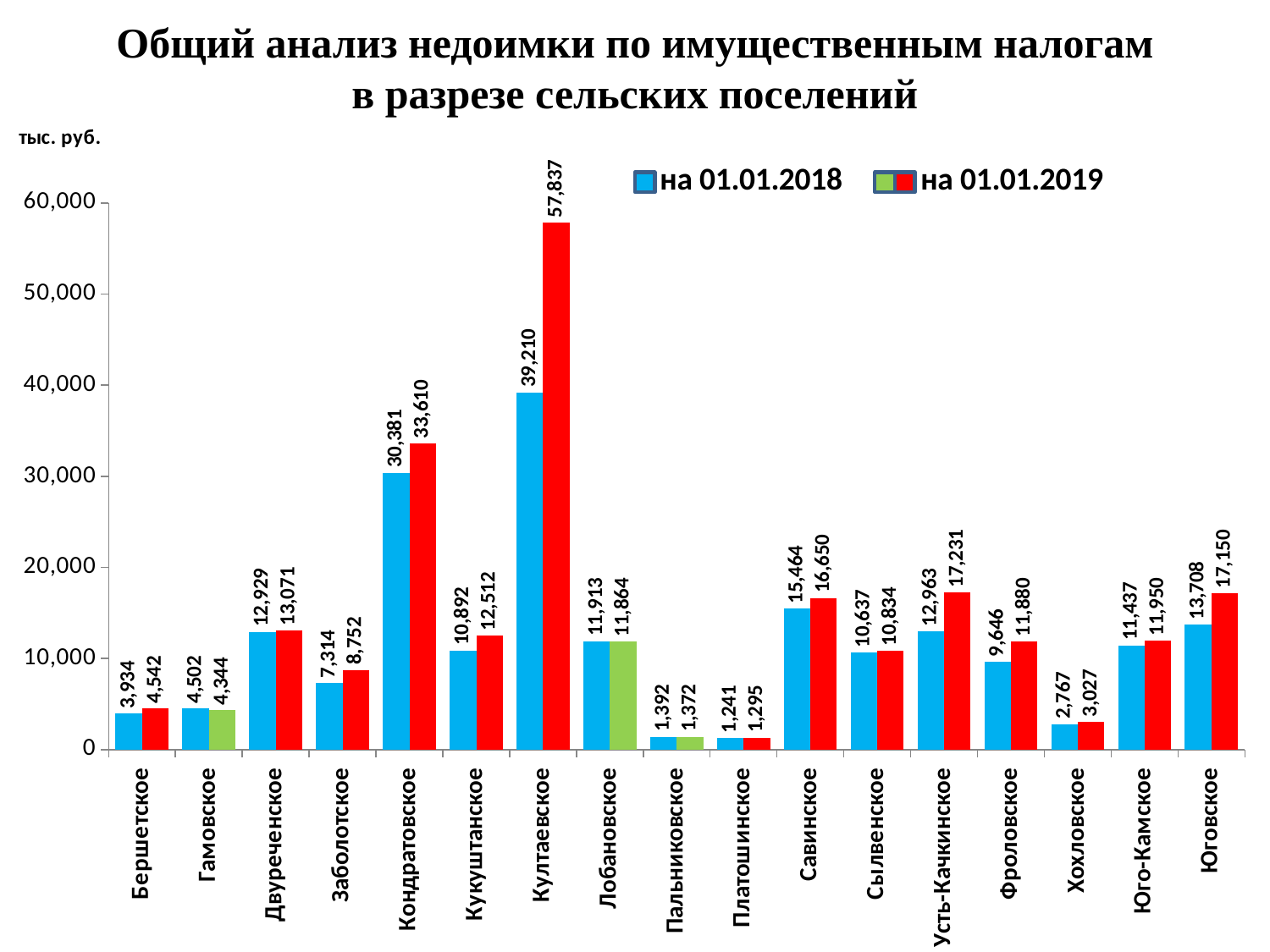
How many series does the legend list? 2 What is the value for Фроловское in the series на 01.01.2019? 11,880 What is the difference between the на 01.01.2019 and на 01.01.2018 values for Култаевское? 18,627 What kind of chart is shown on the slide? bar chart Which category has the lowest value in the series на 01.01.2018? Платошинское What is the difference between the на 01.01.2019 and на 01.01.2018 values for Кондратовское? 3,229 How many categories (settlements) are shown on the x axis? 17 Is the value for Усть-Качкинское in the series на 01.01.2019 greater or less than 20,000? less What is the value for Култаевское in the series на 01.01.2019? 57,837 Which category has the highest value in the series на 01.01.2019? Култаевское For Гамовское, which series has the larger value: на 01.01.2018 or на 01.01.2019? на 01.01.2018 What is the value for Кондратовское in the series на 01.01.2018? 30,381